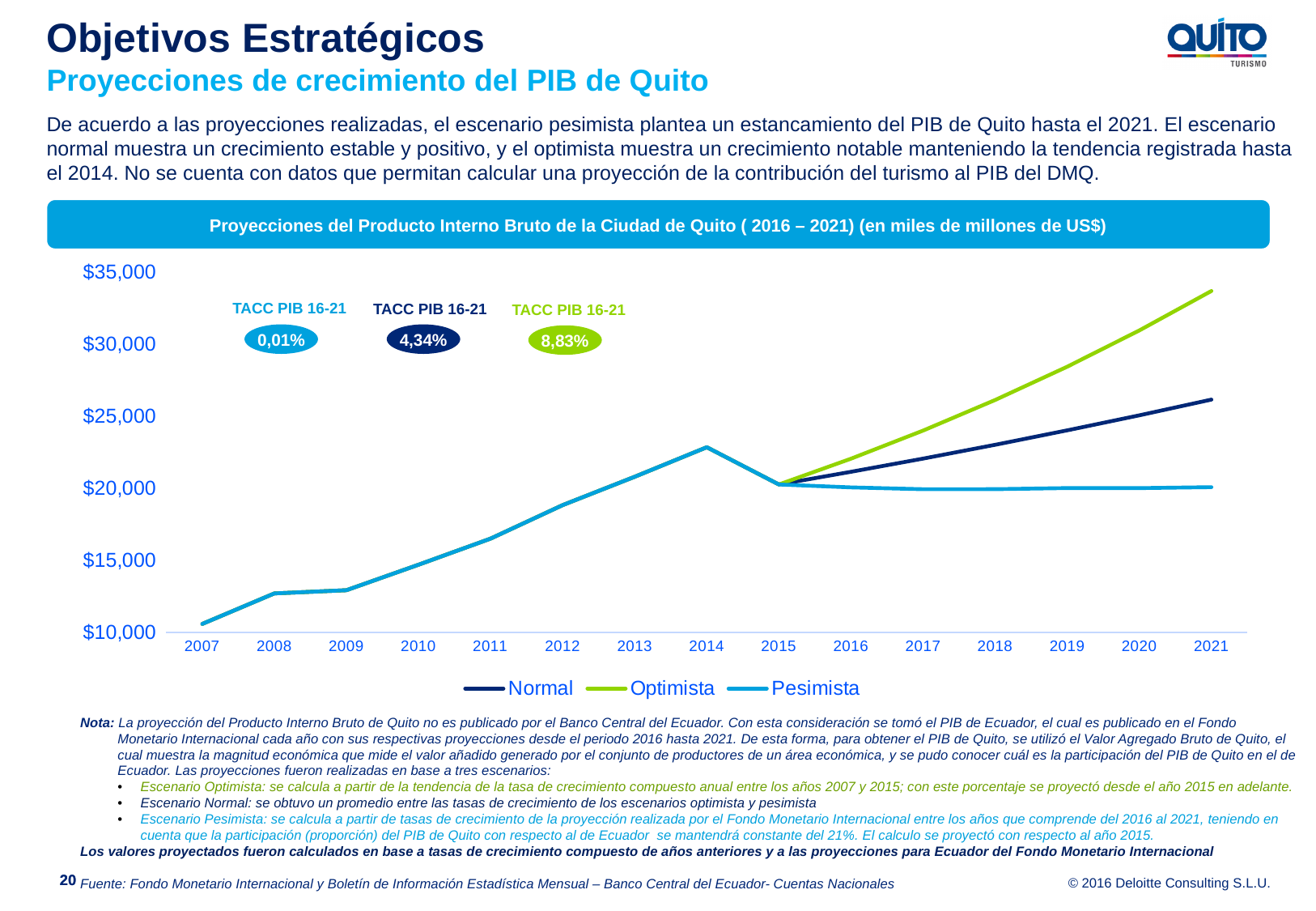
What are the three series named in the chart legend? Normal, Optimista, Pesimista What TACC PIB 16-21 value is shown in the green bubble? 8,83% How many years are shown on the x axis of the chart? 15 Is the value of the Optimista series in 2021 greater or less than $30,000? greater Which series has the highest value in 2021? Optimista Is the value of the Pesimista series in 2021 greater or less than $25,000? less Does the line rise or fall between 2007 and 2014? rise What TACC PIB 16-21 value is shown in the dark blue bubble? 4,34% What is the title of the chart? Proyecciones del Producto Interno Bruto de la Ciudad de Quito ( 2016 – 2021) (en miles de millones de US$) What TACC PIB 16-21 value is shown in the light blue bubble? 0,01% What kind of chart is shown on the slide? line chart How many series does the chart legend list? 3